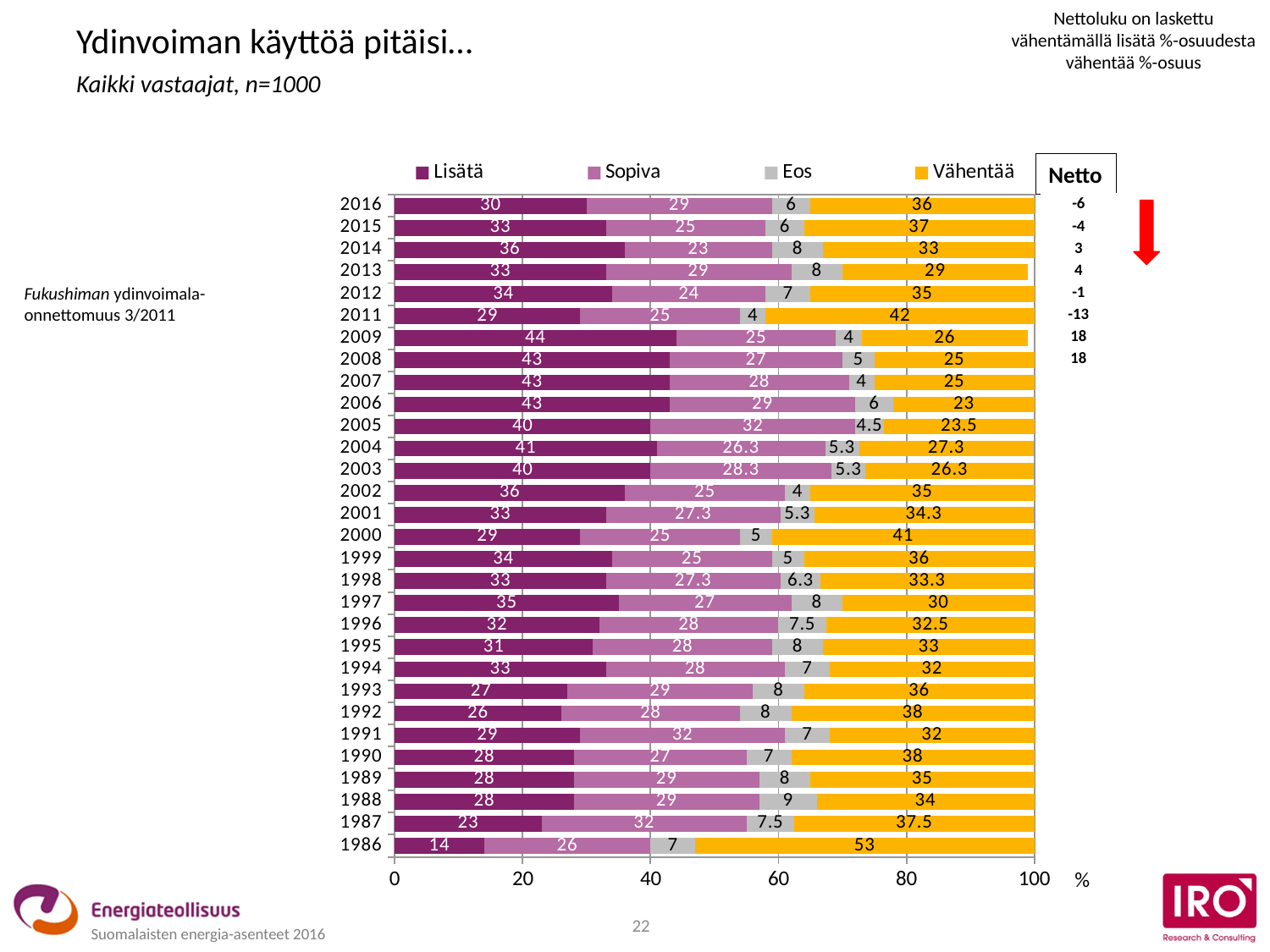
Which year has the lowest Lisätä value? 1986 What is the Vähentää value for 1986? 53 What is the Sopiva value for 2003? 28.3 What kind of chart is shown on the slide? Stacked bar chart What is the Lisätä value for 2016? 30 What is the difference between the Vähentää and Lisätä values for 2016? 6 How many series does the legend list? 4 Which year has the larger Vähentää value, 2011 or 2009? 2011 Which year has the highest Lisätä value? 2009 What is the Eos value for 2005? 4.5 Which year has the highest Vähentää value? 1986 How many years are shown on the chart? 30